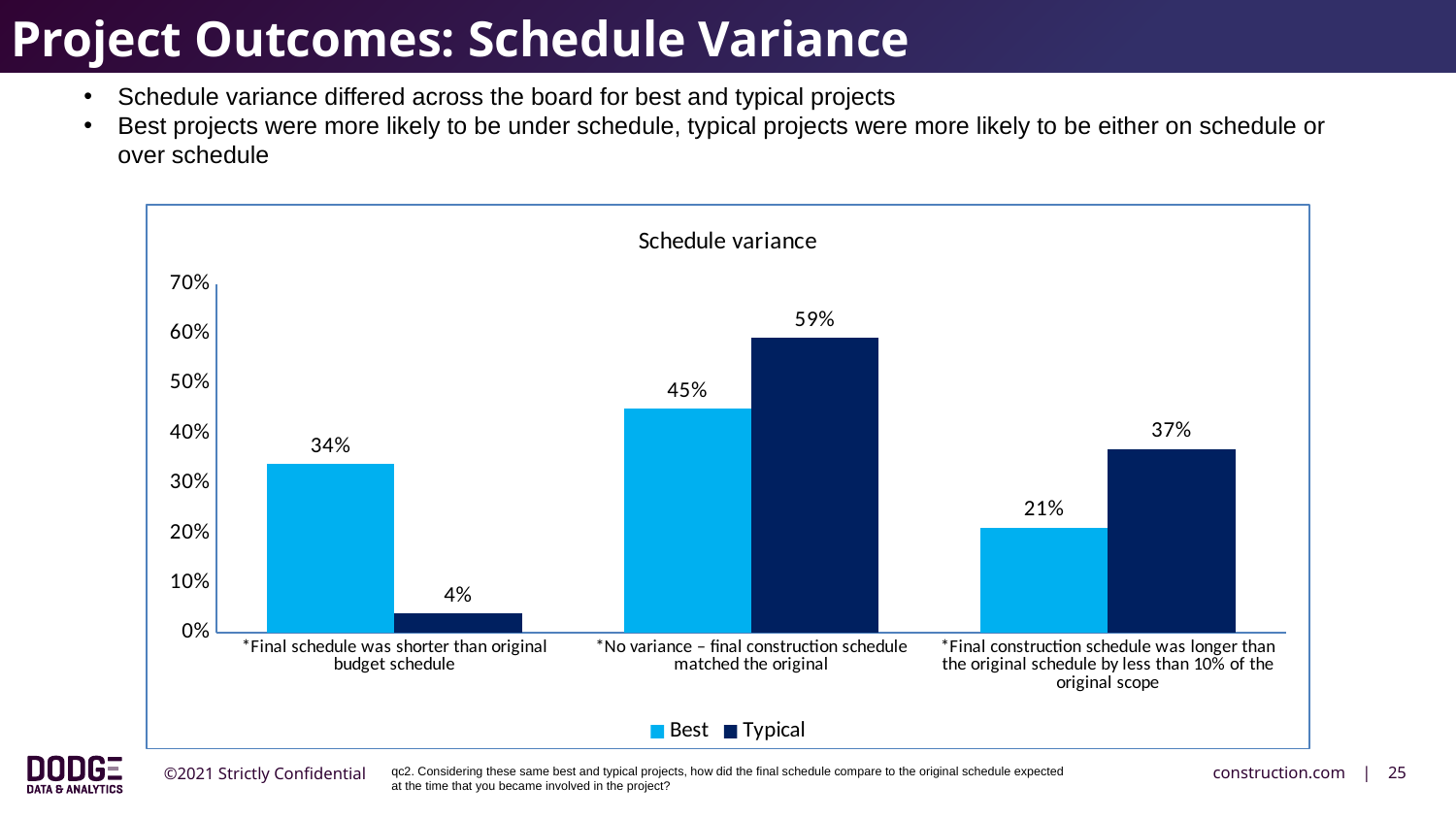
What is the Typical value for 'No variance – final construction schedule matched the original'? 59% What kind of chart is shown? Bar chart What is the Typical value for 'Final schedule was shorter than original budget schedule'? 4% How many categories are shown on the x axis? 3 Which category has the highest Typical value? No variance – final construction schedule matched the original What is the difference between the Typical and Best values for 'No variance – final construction schedule matched the original'? 14% What is the Best value for 'Final construction schedule was longer than the original schedule by less than 10% of the original scope'? 21% For 'Final schedule was shorter than original budget schedule', which series has the larger value, Best or Typical? Best What is the Best value for 'Final schedule was shorter than original budget schedule'? 34% How many series does the legend list? 2 Which category has the lowest Typical value? Final schedule was shorter than original budget schedule What is the title of the chart? Schedule variance